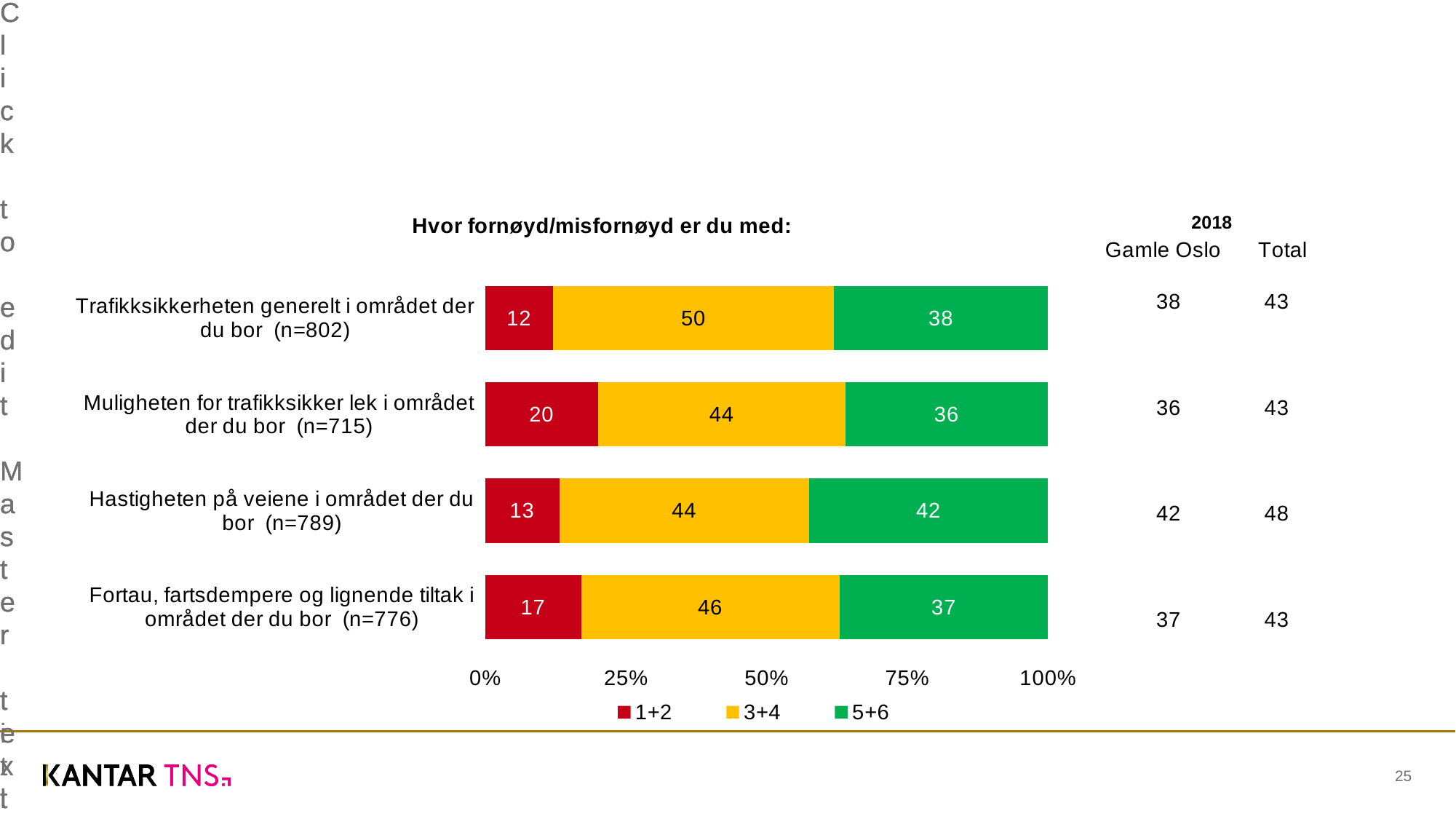
What colour represents the 5+6 series in the chart? Green What is the total of the stacked bar for "Muligheten for trafikksikker lek i området der du bor (n=715)"? 100 Which is larger: the 5+6 value for "Hastigheten på veiene i området der du bor (n=789)" or for "Fortau, fartsdempere og lignende tiltak i området der du bor (n=776)"? Hastigheten på veiene i området der du bor (n=789) What is the value of the 1+2 series for "Trafikksikkerheten generelt i området der du bor (n=802)"? 12 How many categories are shown in the chart? 4 What kind of chart is shown on the slide? Stacked bar chart What is the difference between the 3+4 values for "Trafikksikkerheten generelt i området der du bor (n=802)" and "Muligheten for trafikksikker lek i området der du bor (n=715)"? 6 What is the value of the 5+6 series for "Hastigheten på veiene i området der du bor (n=789)"? 42 Which category has the highest value for the 1+2 series? Muligheten for trafikksikker lek i området der du bor (n=715) What is the value of the 3+4 series for "Fortau, fartsdempere og lignende tiltak i området der du bor (n=776)"? 46 Which category has the lowest value for the 5+6 series? Muligheten for trafikksikker lek i området der du bor (n=715) How many series does the legend list? 3